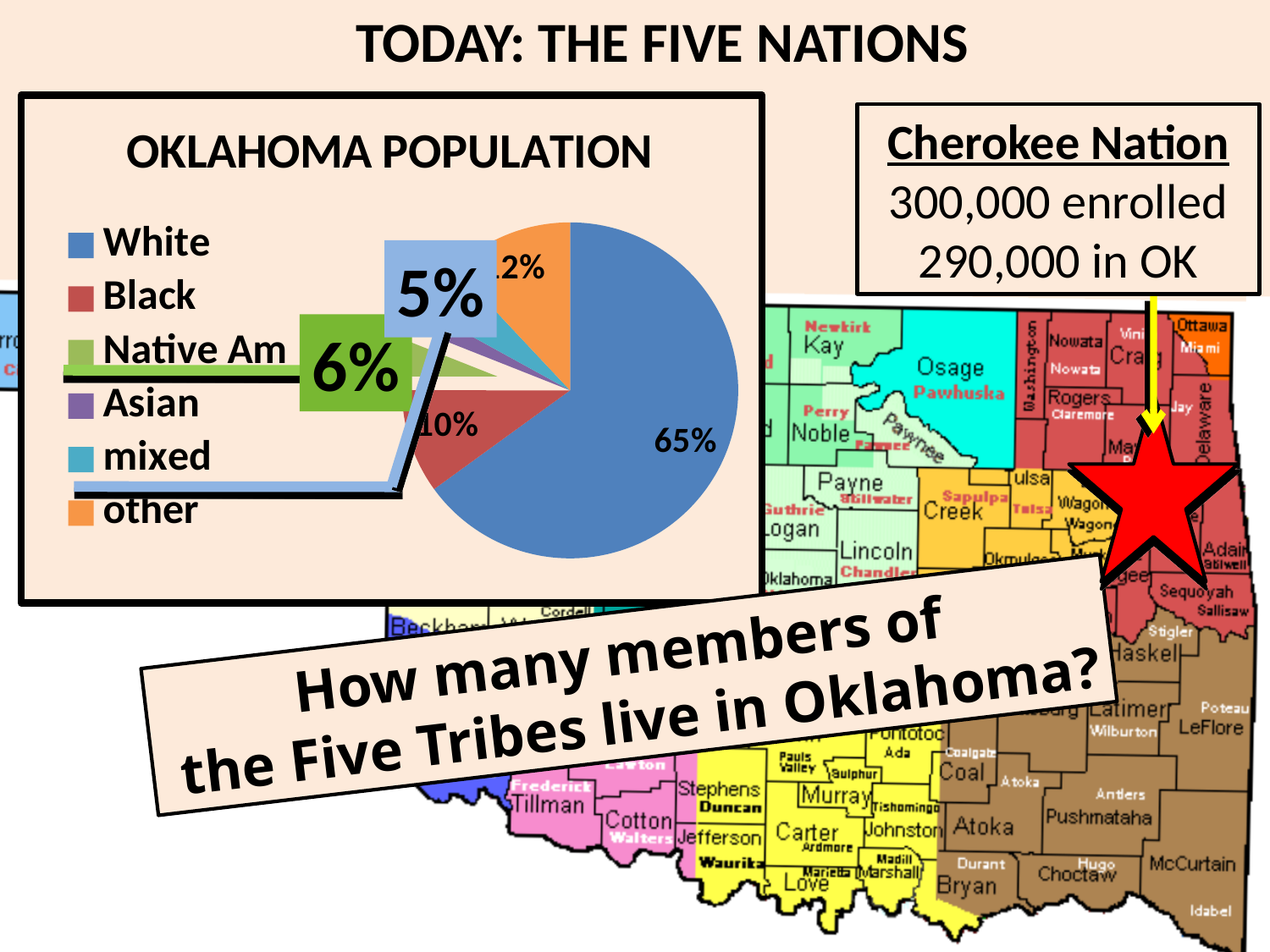
Which is larger in the pie chart, the Black share or the Native Am share? Black Is the White share of the pie chart greater or less than 50%? greater What percentage of the Oklahoma population is White according to the pie chart? 65% How many categories does the legend of the Oklahoma Population chart list? 6 What is the title of the pie chart? OKLAHOMA POPULATION What kind of chart is shown on the slide? pie chart Which category has the largest slice in the Oklahoma Population pie chart? White What is the difference between the White share and the Black share in the pie chart? 55% What percentage of the Oklahoma population is Black according to the pie chart? 10% What percentage does the blue callout give for mixed in the pie chart? 5% What percentage does the green callout give for Native Am in the pie chart? 6% What colour represents White in the pie chart legend? blue